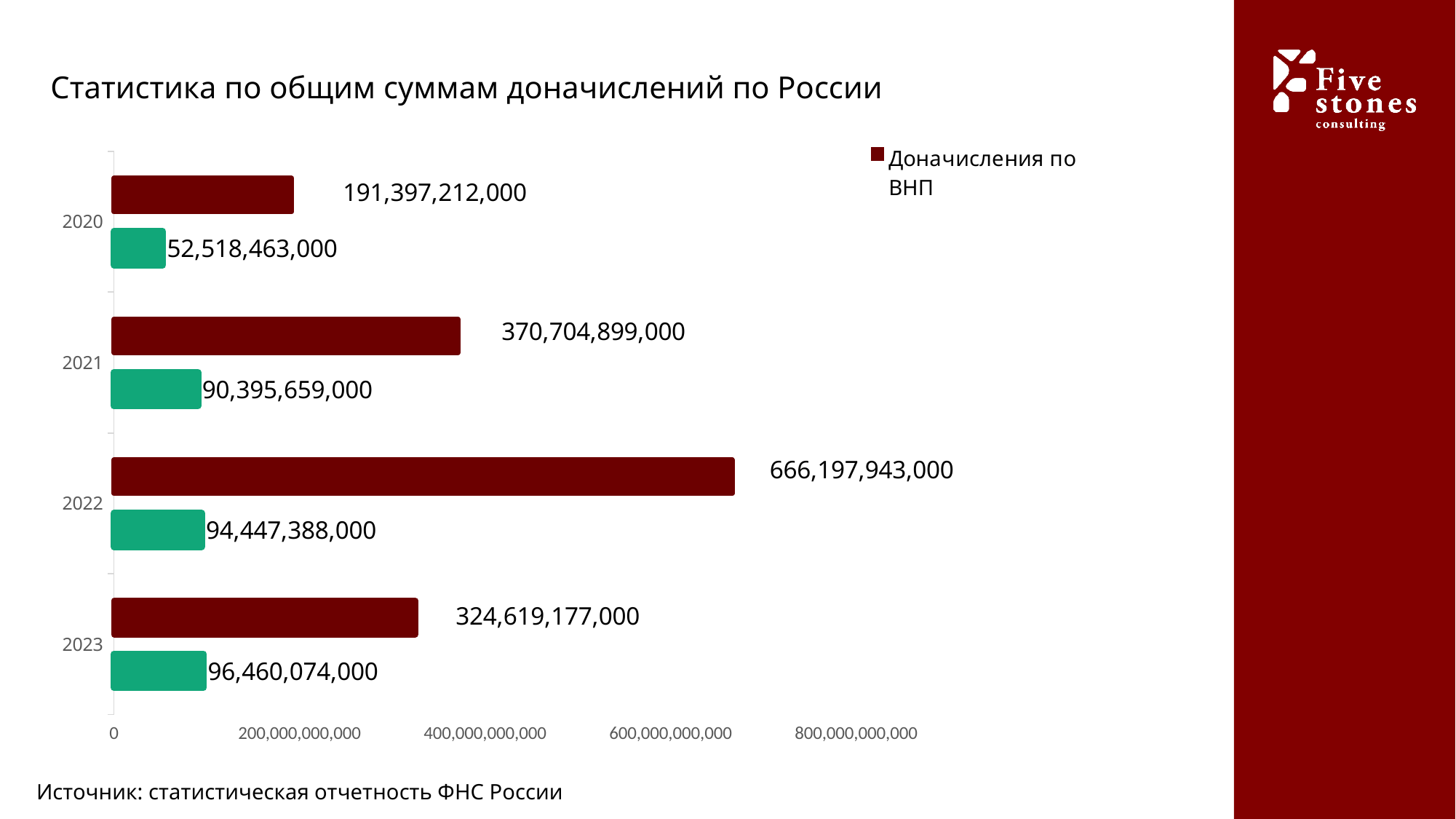
What is the difference between the green bar values for 2023 and 2020? 43,941,611,000 Do the green bar values rise or fall from 2020 to 2023? rise What is the value of the green bar for 2021? 90,395,659,000 What is the value of Доначисления по ВНП for 2020? 191,397,212,000 What is the value of Доначисления по ВНП for 2022? 666,197,943,000 How many series does the legend list? 1 Which year has the highest value for Доначисления по ВНП? 2022 What is the difference between the Доначисления по ВНП values for 2022 and 2021? 295,493,044,000 What kind of chart is shown on the slide? bar chart Which is larger: Доначисления по ВНП for 2021 or for 2023? 2021 Which year has the lowest value for the green bars? 2020 How many years are shown on the chart? 4